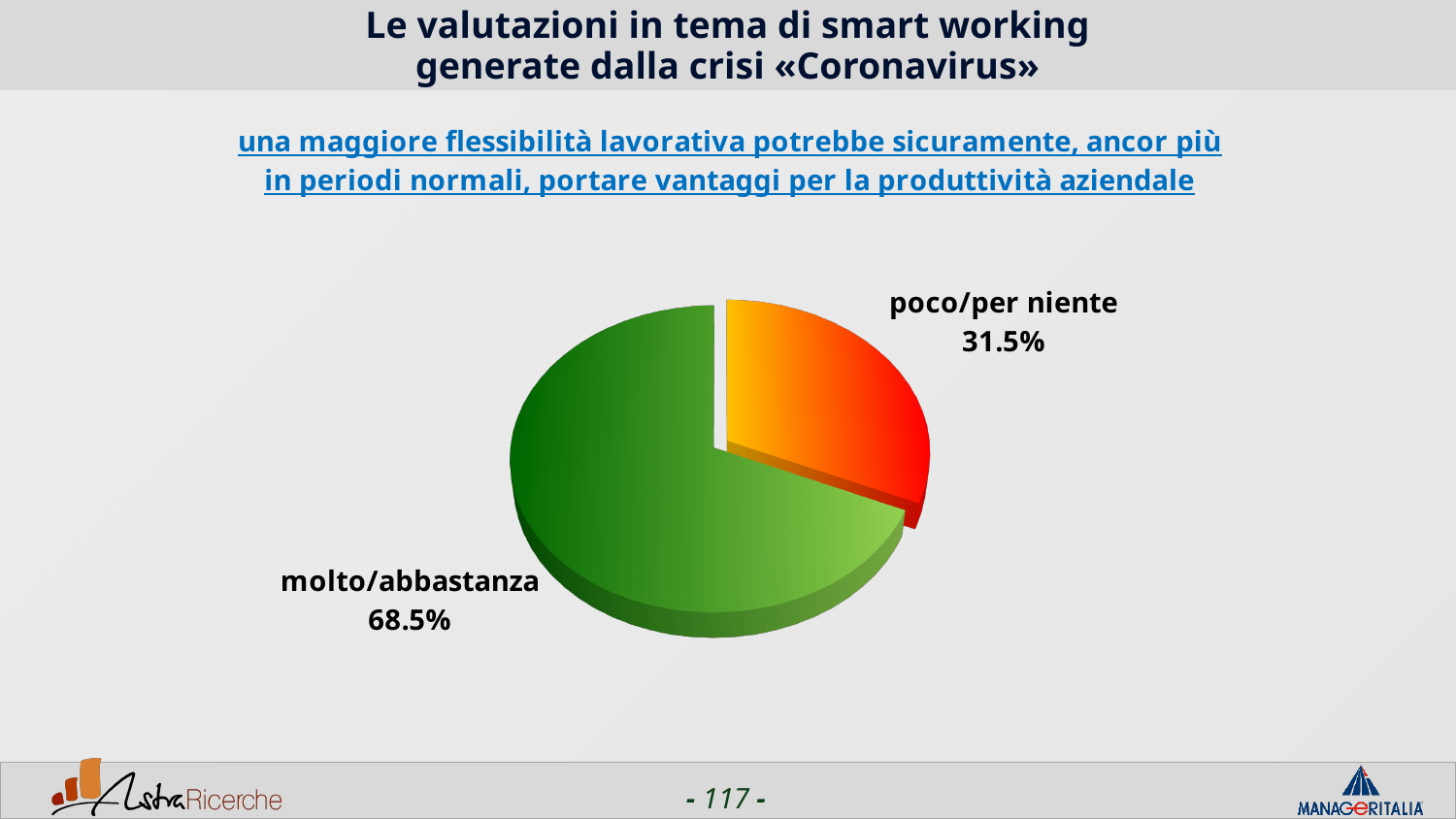
What is the value for "molto/abbastanza"? 68.5% How many slices does the pie chart have? 2 What colour is the "poco/per niente" slice? orange/red What is the difference between the "molto/abbastanza" and "poco/per niente" values? 37 percentage points Which slice is the smallest? poco/per niente What is the value for "poco/per niente"? 31.5% Which is larger, "molto/abbastanza" or "poco/per niente"? molto/abbastanza What kind of chart is shown on the slide? pie chart Which slice is the largest? molto/abbastanza What share of the pie does "poco/per niente" represent? 31.5% What colour is the "molto/abbastanza" slice? green